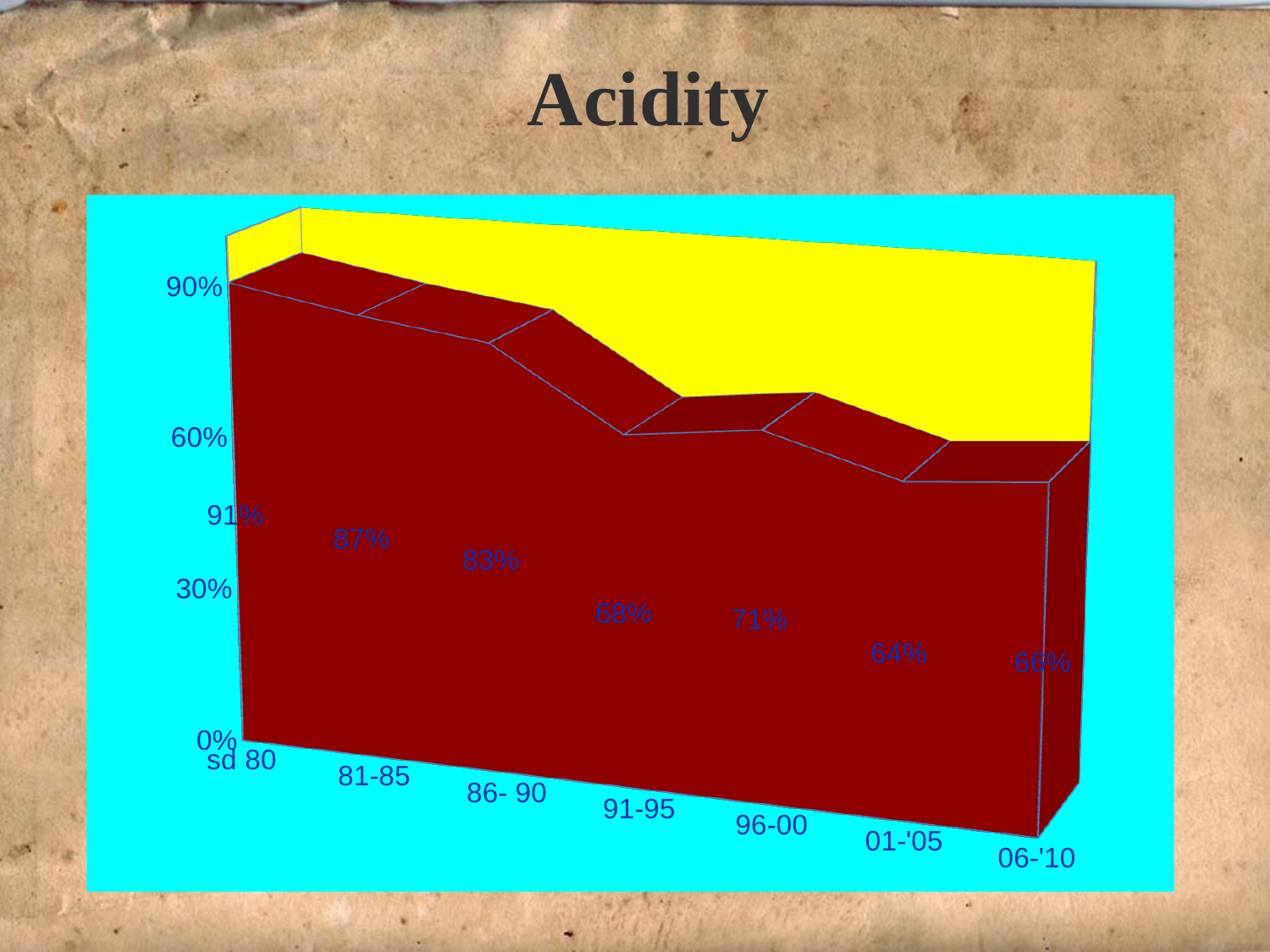
What is the difference between the values for sd 80 and 06-'10? 25% How many periods are shown on the x axis? 7 Is the value for 86- 90 greater or less than 60%? greater What is the value for 91-95? 68% What kind of chart is shown on the slide? area chart Which period has the lowest value? 01-'05 Which is larger, the value for 96-00 or the value for 91-95? 96-00 Do the values generally rise or fall from sd 80 to 06-'10? fall Which period has the highest value? sd 80 What is the title of the chart? Acidity What is the value for 81-85? 87% What is the value for 06-'10? 66%